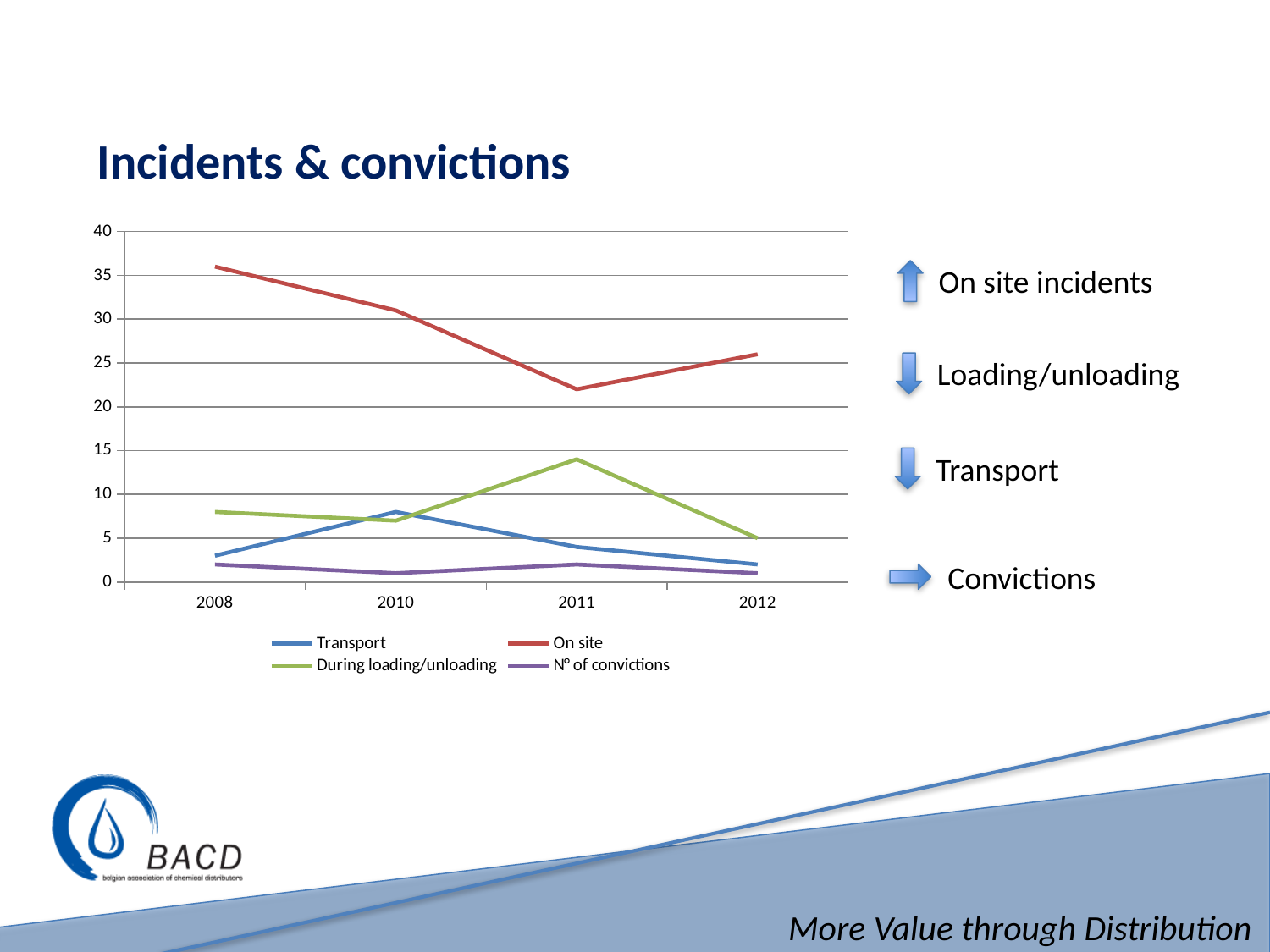
Is the During loading/unloading value for 2011 greater or less than 10? greater In which year does the During loading/unloading series peak? 2011 Is the On site value for 2011 greater or less than 25? less Which is larger in 2011, the During loading/unloading value or the Transport value? During loading/unloading In which year is the On site series at its highest? 2008 How many series does the legend list? 4 What kind of chart is shown on the slide? line chart Which series is drawn in red? On site In which year is the On site series at its lowest? 2011 Does the On site series rise or fall from 2008 to 2011? fall How many years are plotted along the x axis? 4 Is the On site value for 2008 greater or less than 30? greater